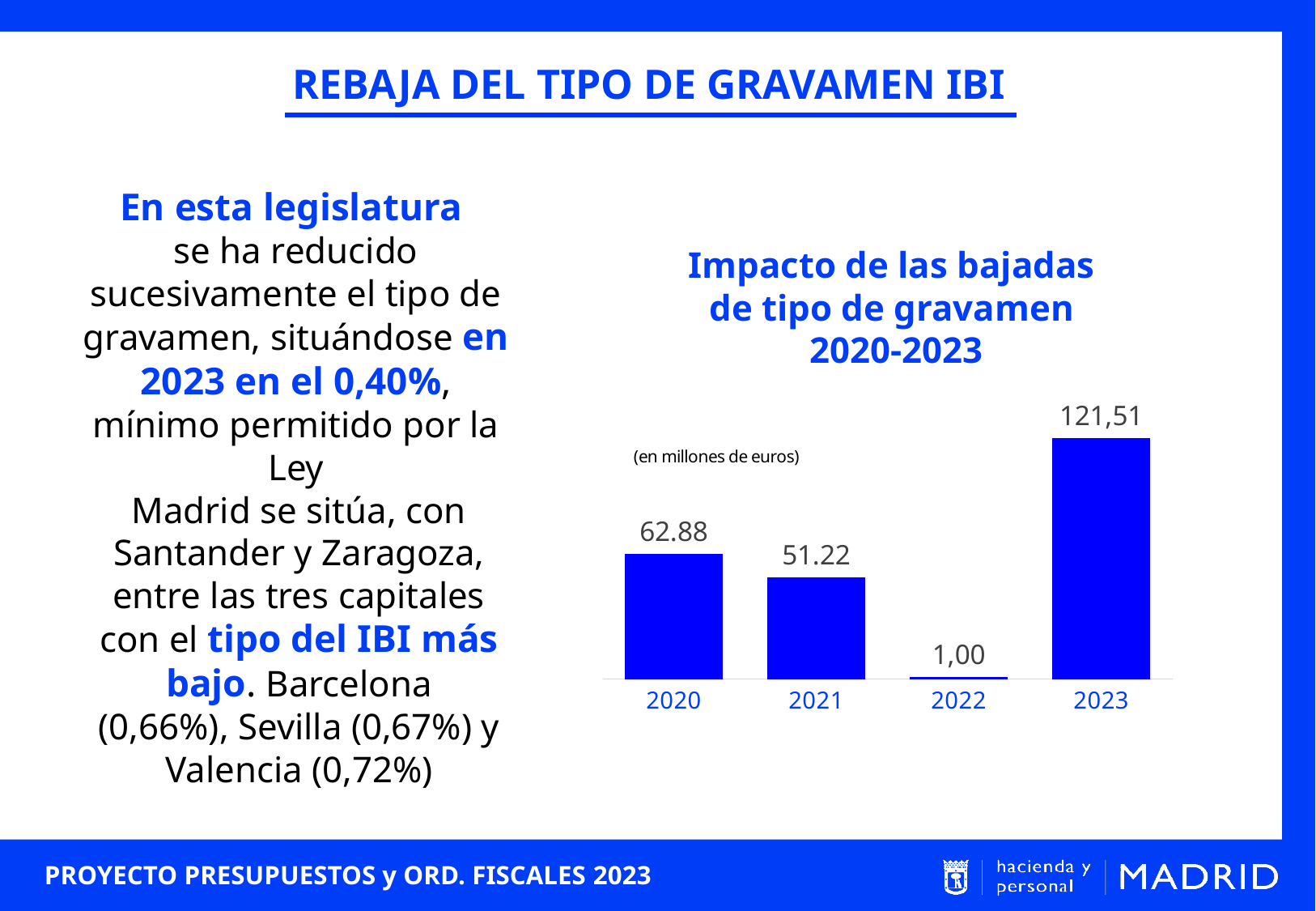
How many years are shown in the chart? 4 What is the value shown for 2022 in the chart? 1,00 Does the value rise or fall from 2020 to 2021? Fall Which year has the highest value in the chart? 2023 What is the difference between the values for 2020 and 2021? 11.66 Which is larger, the value for 2020 or the value for 2021? 2020 What is the value shown for 2023 in the chart? 121,51 What is the value shown for 2020 in the chart? 62.88 Which year has the lowest value in the chart? 2022 What is the value shown for 2021 in the chart? 51.22 What kind of chart is shown on the slide? Bar chart What unit is stated for the values in the chart? en millones de euros